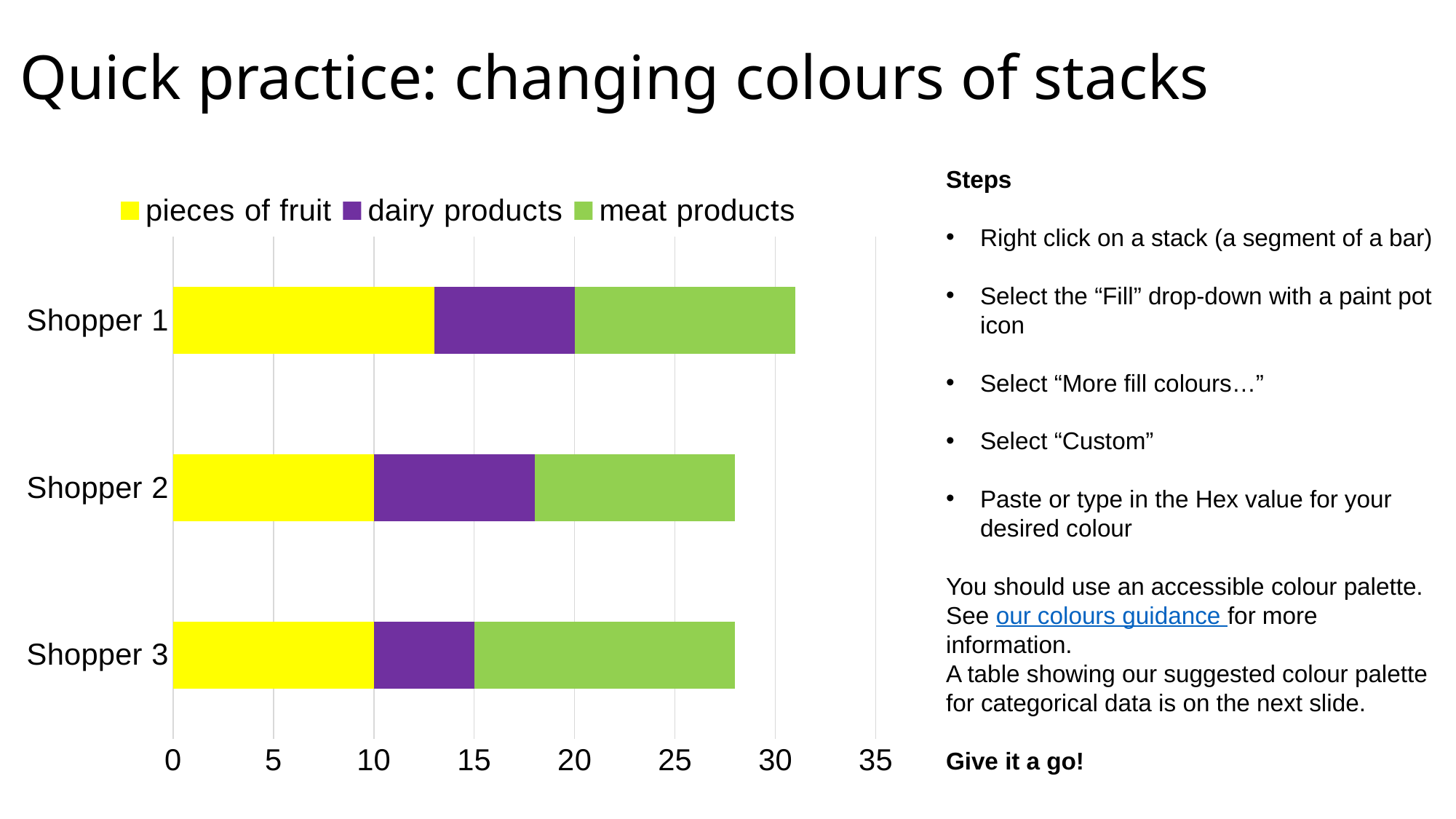
Is the total bar for Shopper 1 greater or less than 30? greater Which is larger: dairy products for Shopper 2 or dairy products for Shopper 3? Shopper 2 What kind of chart is shown on the slide? bar chart Is the pieces of fruit value for Shopper 1 greater or less than 10? greater How many series does the chart legend list? 3 What colour represents dairy products in the chart? purple What is the value of pieces of fruit for Shopper 3? 10 Which is larger: pieces of fruit for Shopper 1 or pieces of fruit for Shopper 2? Shopper 1 How many shoppers (categories) are shown in the chart? 3 Is the total bar for Shopper 2 greater or less than 30? less What is the value of pieces of fruit for Shopper 2? 10 Which shopper has the longest total bar? Shopper 1